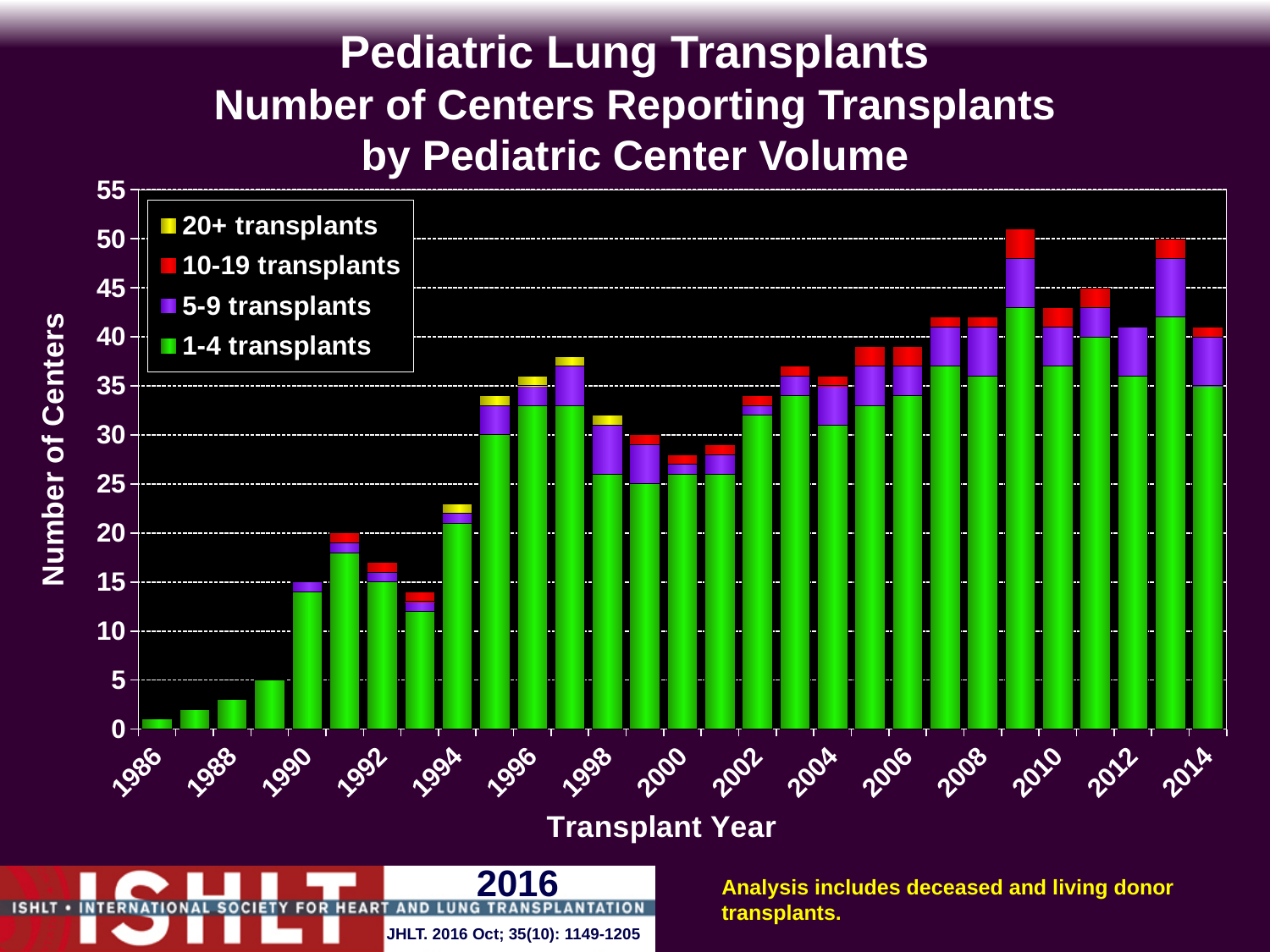
Is the total number of centers for 2012 greater or less than 40? greater What kind of chart is shown on the slide? Stacked bar chart Which year has a larger total number of centers, 2009 or 2000? 2009 How many series does the legend list? 4 Is the total number of centers for 2009 greater or less than 50? greater Do the total number of centers rise or fall from 1986 to 1990? rise Which year has a larger total number of centers, 1990 or 1986? 1990 Which legend entry is shown in green? 1-4 transplants Is the total number of centers for 2000 greater or less than 30? less What is the label of the y axis? Number of Centers Which transplant year has the lowest total number of centers? 1986